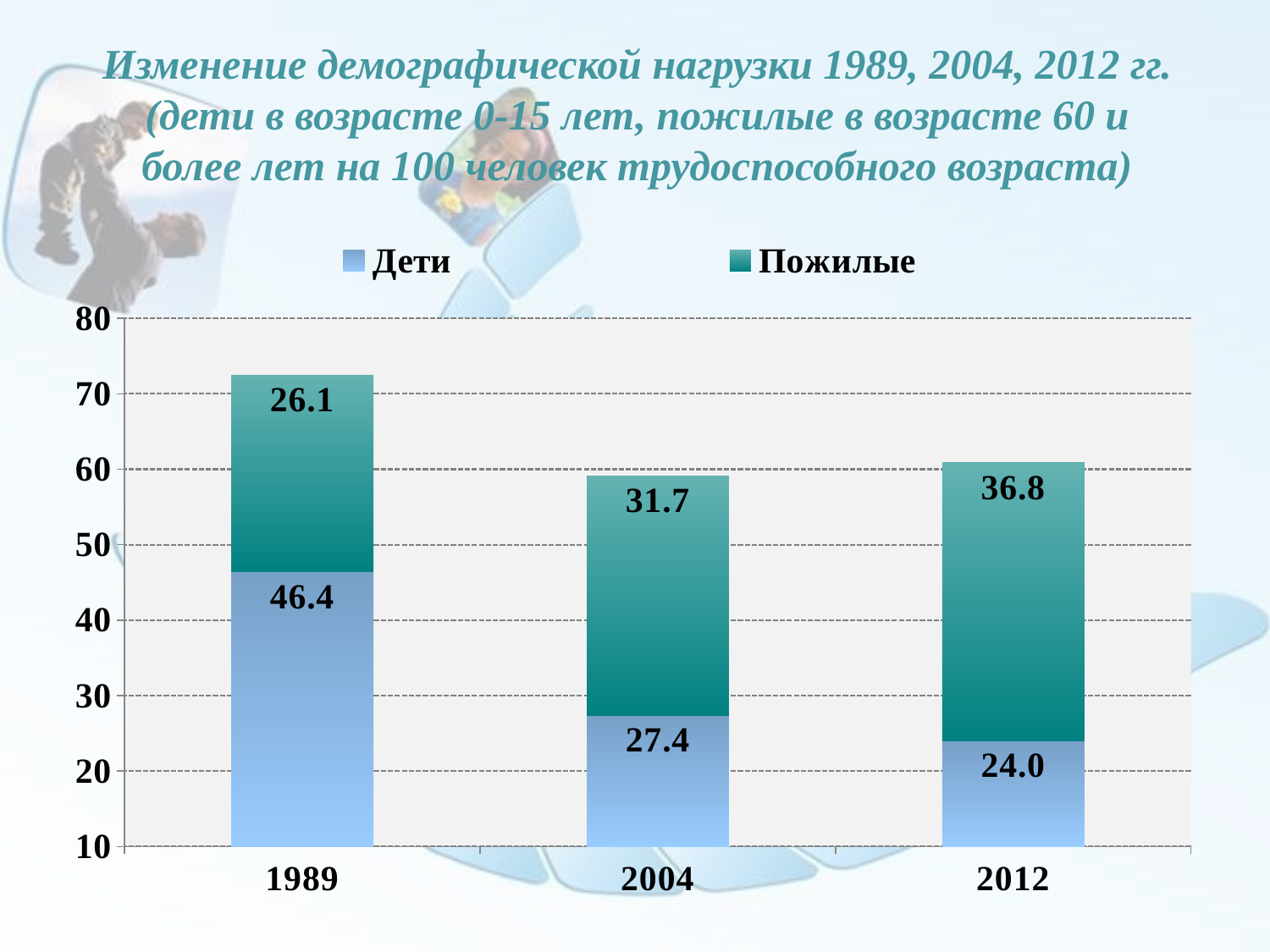
How many years are shown on the x axis? 3 What is the difference between the Пожилые values for 2012 and 1989? 10.7 What is the value for Пожилые in 2012? 36.8 What is the value for Дети in 1989? 46.4 In which year is the Дети value lowest? 2012 What is the total of the stacked bar for 2012? 60.8 How many series does the legend list? 2 What is the total of the stacked bar for 1989? 72.5 What is the value for Дети in 2004? 27.4 What kind of chart is shown on the slide? Stacked bar chart In which year is the Пожилые value highest? 2012 Which is larger in 2004, the Дети value or the Пожилые value? Пожилые